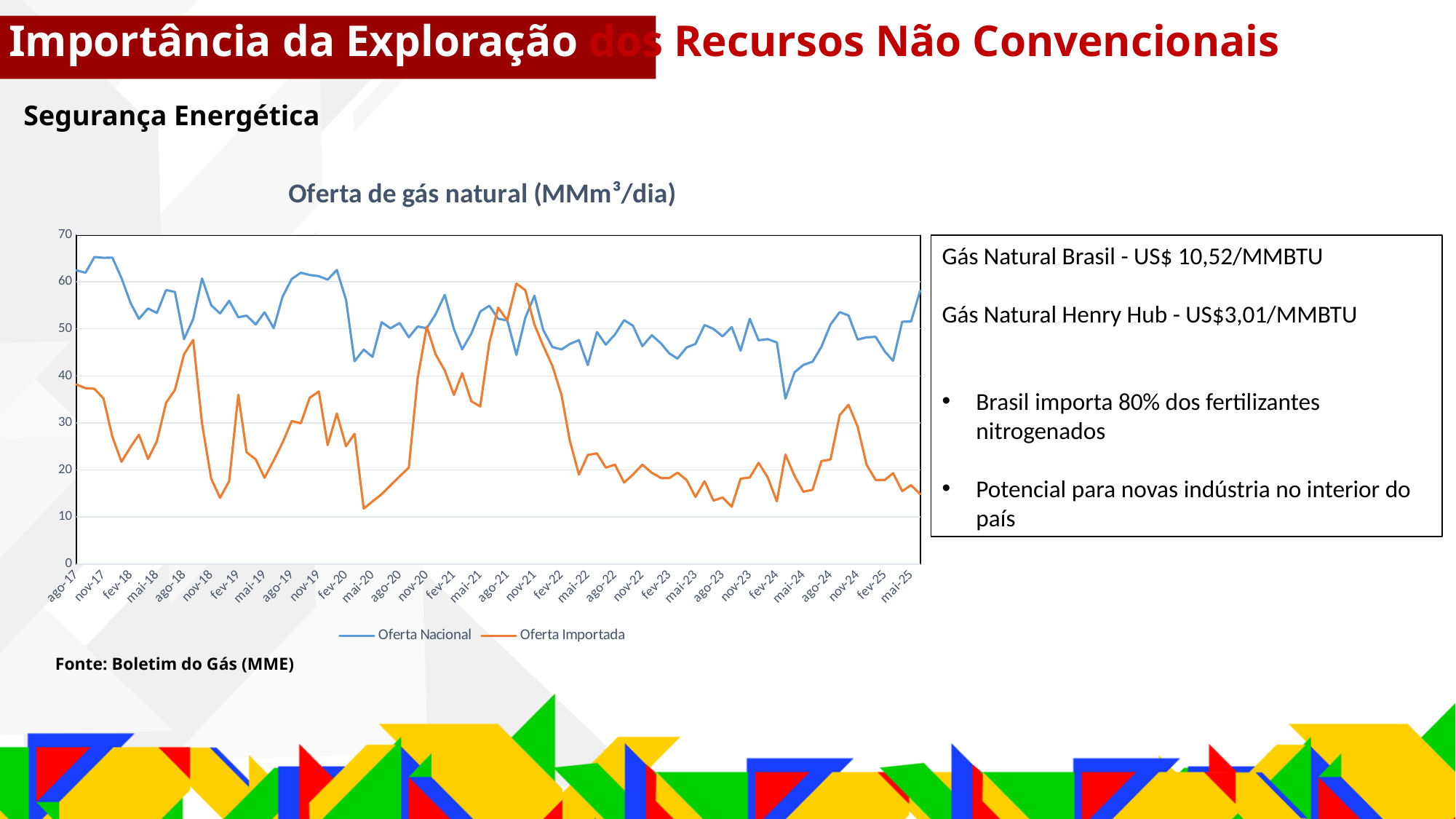
How many series does the legend of the chart list? 2 At ago-17, which series has the larger value, Oferta Nacional or Oferta Importada? Oferta Nacional Does Oferta Importada rise or fall between fev-22 and mai-22? fall Is the value of Oferta Importada at ago-23 greater or less than 20? less Is the value of Oferta Nacional at mai-20 greater or less than 50? less Which series is drawn in orange in the chart? Oferta Importada Is the value of Oferta Importada at mai-20 greater or less than 20? less At mai-21, which series has the larger value, Oferta Nacional or Oferta Importada? Oferta Nacional What kind of chart is shown on the slide? line chart What is the title of the chart? Oferta de gás natural (MMm³/dia) Does Oferta Importada rise or fall between mai-20 and nov-20? rise